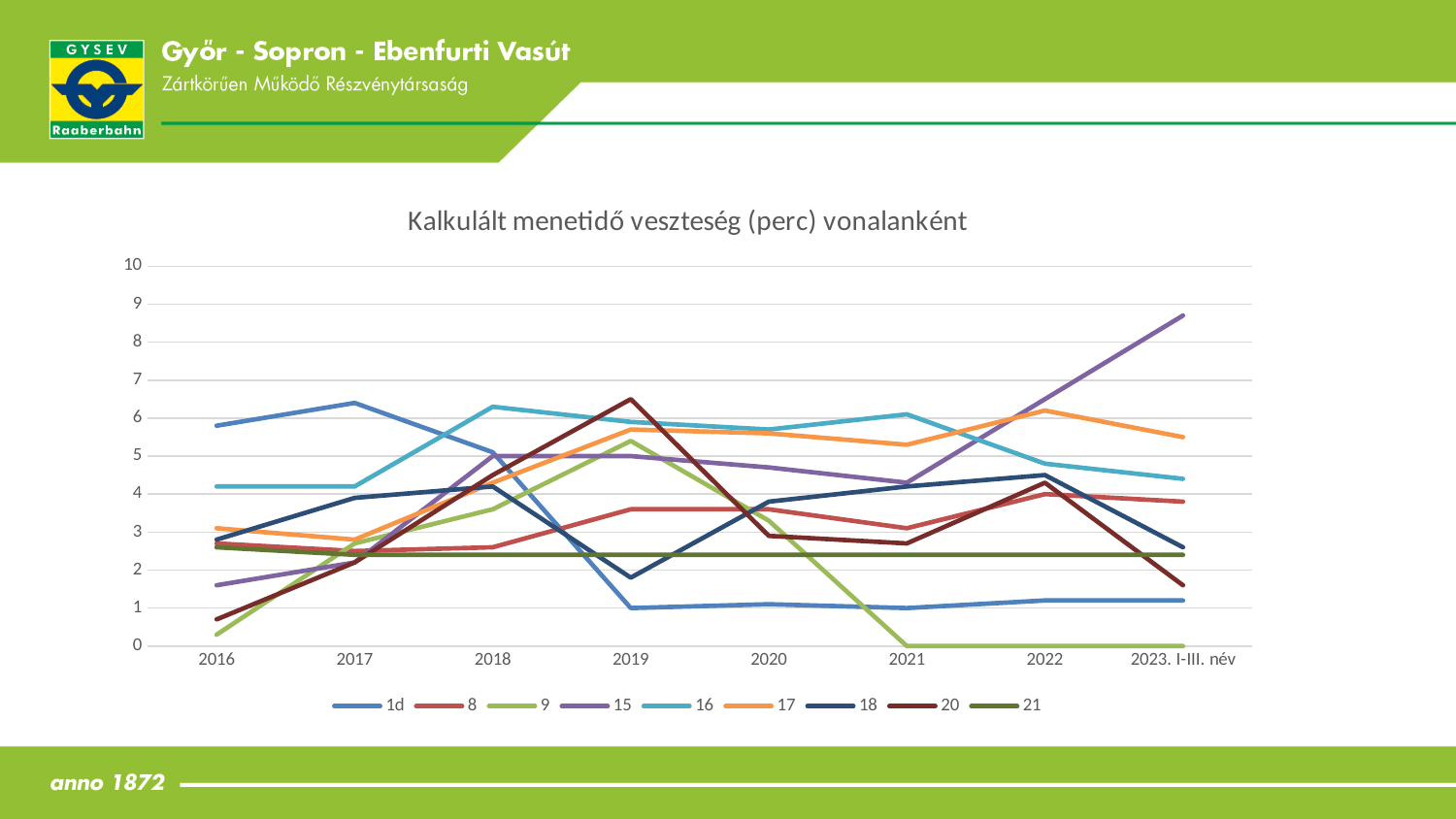
Which series has the lowest value at 2022? 9 Does series 15 rise or fall from 2021 to 2023. I-III. név? rise Which series has the highest value in 2016? 1d Which series has the highest value at 2023. I-III. név? 15 At 2023. I-III. név, which is larger: series 17 or series 16? 17 What is the title of the chart? Kalkulált menetidő veszteség (perc) vonalanként Is the value for series 9 in 2016 greater or less than 1? less Is the value for series 15 at 2023. I-III. név greater or less than 8? greater How many points are there along the x axis? 8 What kind of chart is shown on the slide? line chart How many series does the legend list? 9 What is the value for series 9 in 2022? 0